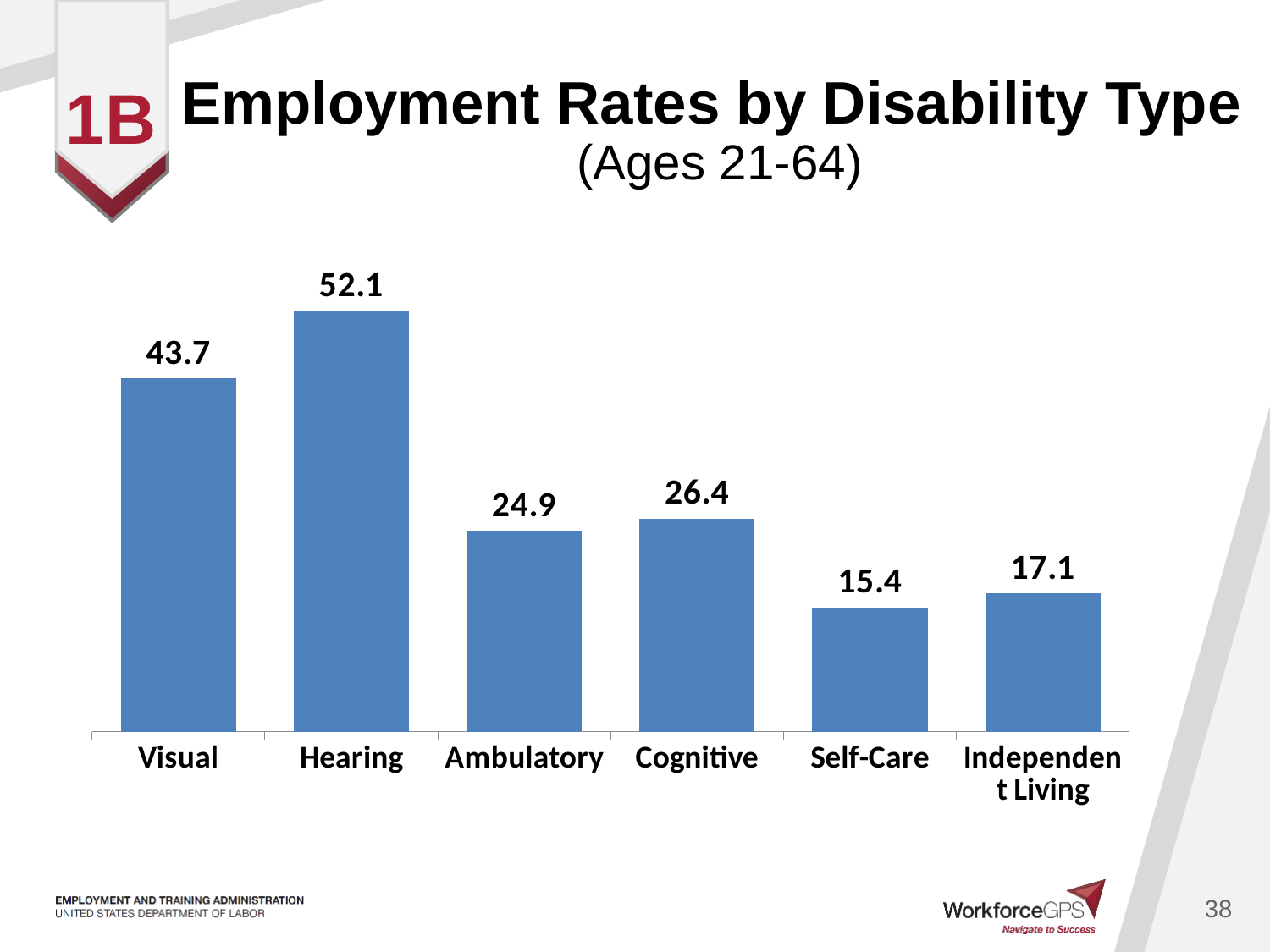
Which disability type has the highest employment rate? Hearing Which has a higher employment rate, Cognitive or Ambulatory? Cognitive What is the difference between the employment rates for Hearing and Visual? 8.4 What is the employment rate for Independent Living? 17.1 What is the employment rate for the Hearing disability type? 52.1 What is the employment rate for the Visual disability type? 43.7 How many disability types are shown in the chart? 6 What is the employment rate for the Self-Care disability type? 15.4 What is the difference between the employment rates for Cognitive and Ambulatory? 1.5 What kind of chart is shown on the slide? Bar chart Which disability type has the lowest employment rate? Self-Care What age range does the chart title say the employment rates cover? Ages 21-64